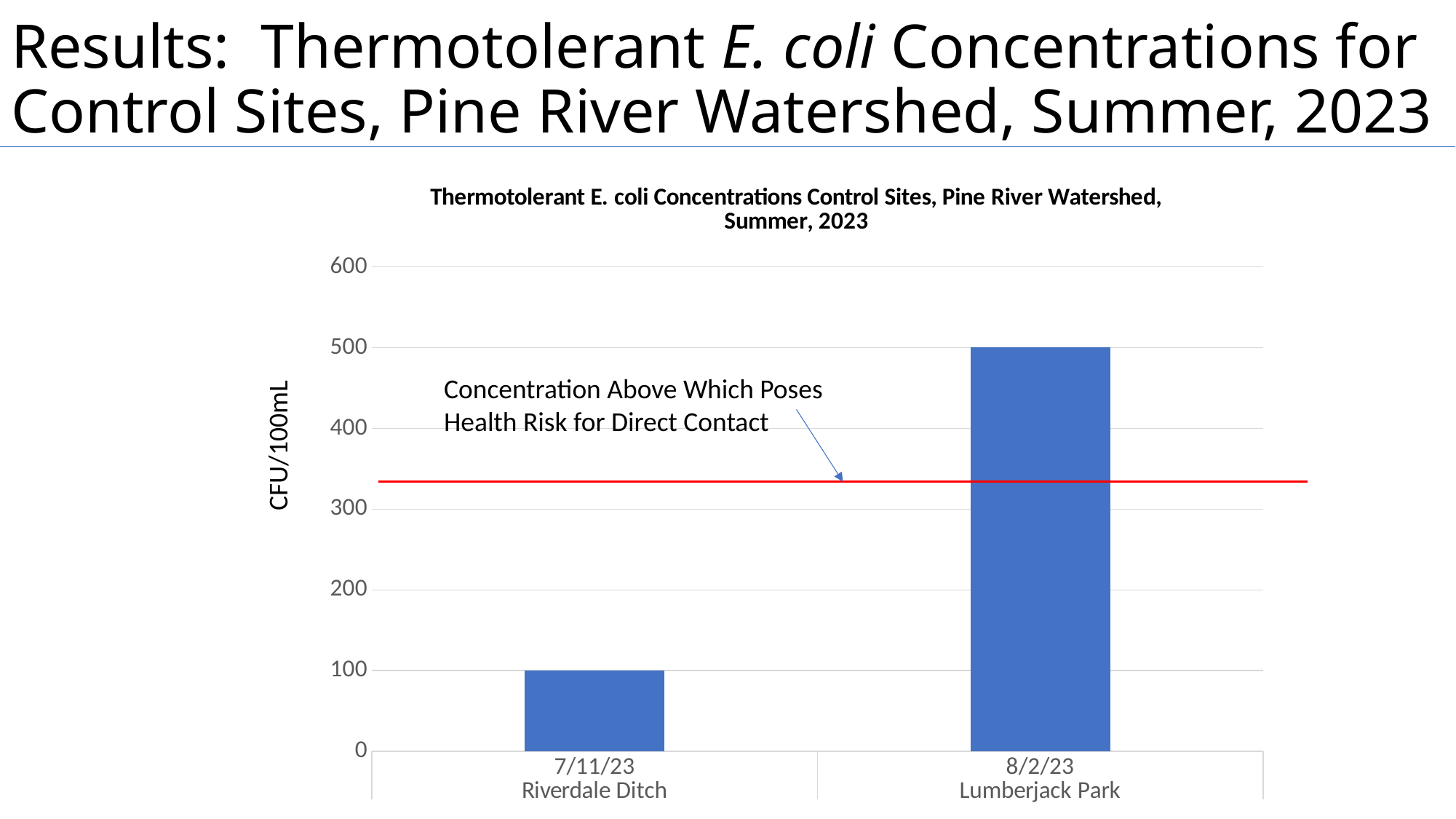
Which site has the highest E. coli concentration? Lumberjack Park Which site has the lowest E. coli concentration? Riverdale Ditch What kind of chart is shown on the slide? bar chart What does the red horizontal line on the chart represent? Concentration Above Which Poses Health Risk for Direct Contact Is the value for Lumberjack Park greater or less than 400? greater How many sites are plotted in the chart? 2 Which has a larger E. coli concentration, Riverdale Ditch or Lumberjack Park? Lumberjack Park What is the label on the vertical axis of the chart? CFU/100mL Is the value for Riverdale Ditch greater or less than 200? less What is the E. coli concentration for Riverdale Ditch on 7/11/23? 100 What is the difference in E. coli concentration between Lumberjack Park and Riverdale Ditch? 400 What is the E. coli concentration for Lumberjack Park on 8/2/23? 500